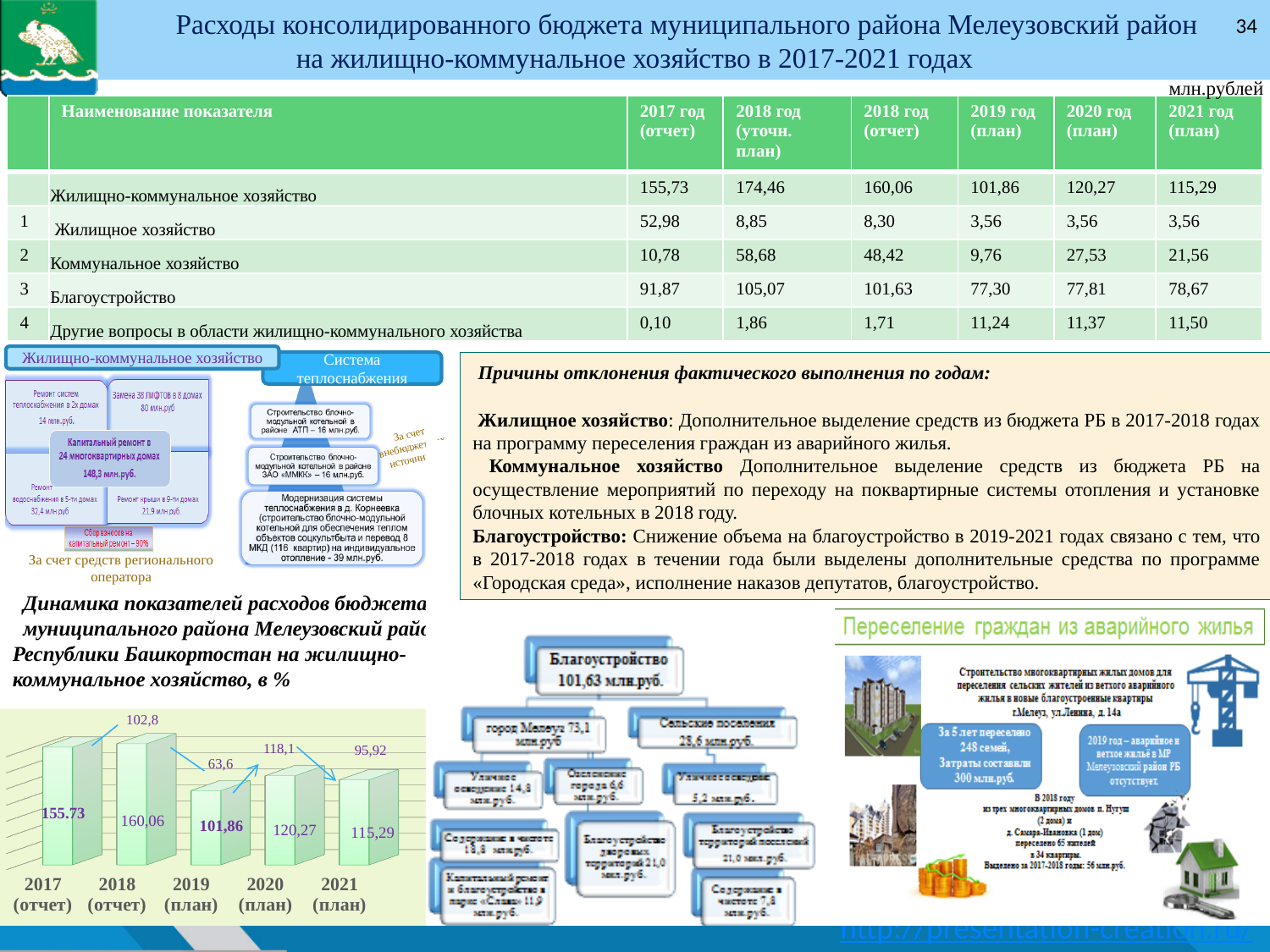
In the bar chart at the bottom left, which year has the highest value? 2018 (отчет) In the bar chart at the bottom left, which is larger: the value for 2020 (план) or 2021 (план)? 2020 (план) In the bar chart at the bottom left, what is the difference between the values for 2020 (план) and 2021 (план)? 4,98 In the bar chart at the bottom left, what is the value for 2021 (план)? 115,29 How many bars are shown in the bar chart at the bottom left? 5 In the bar chart at the bottom left, what is the difference between the values for 2018 (отчет) and 2017 (отчет)? 4,33 In the bar chart at the bottom left, what is the value for 2017 (отчет)? 155.73 In the bar chart at the bottom left, what percentage label is shown above the 2018 bar? 102,8 What kind of chart is shown at the bottom left of the slide? Bar chart In the bar chart at the bottom left, which year has the lowest value? 2019 (план) In the bar chart at the bottom left, what is the value for 2019 (план)? 101,86 In the bar chart at the bottom left, does the value rise or fall from 2018 (отчет) to 2019 (план)? Fall